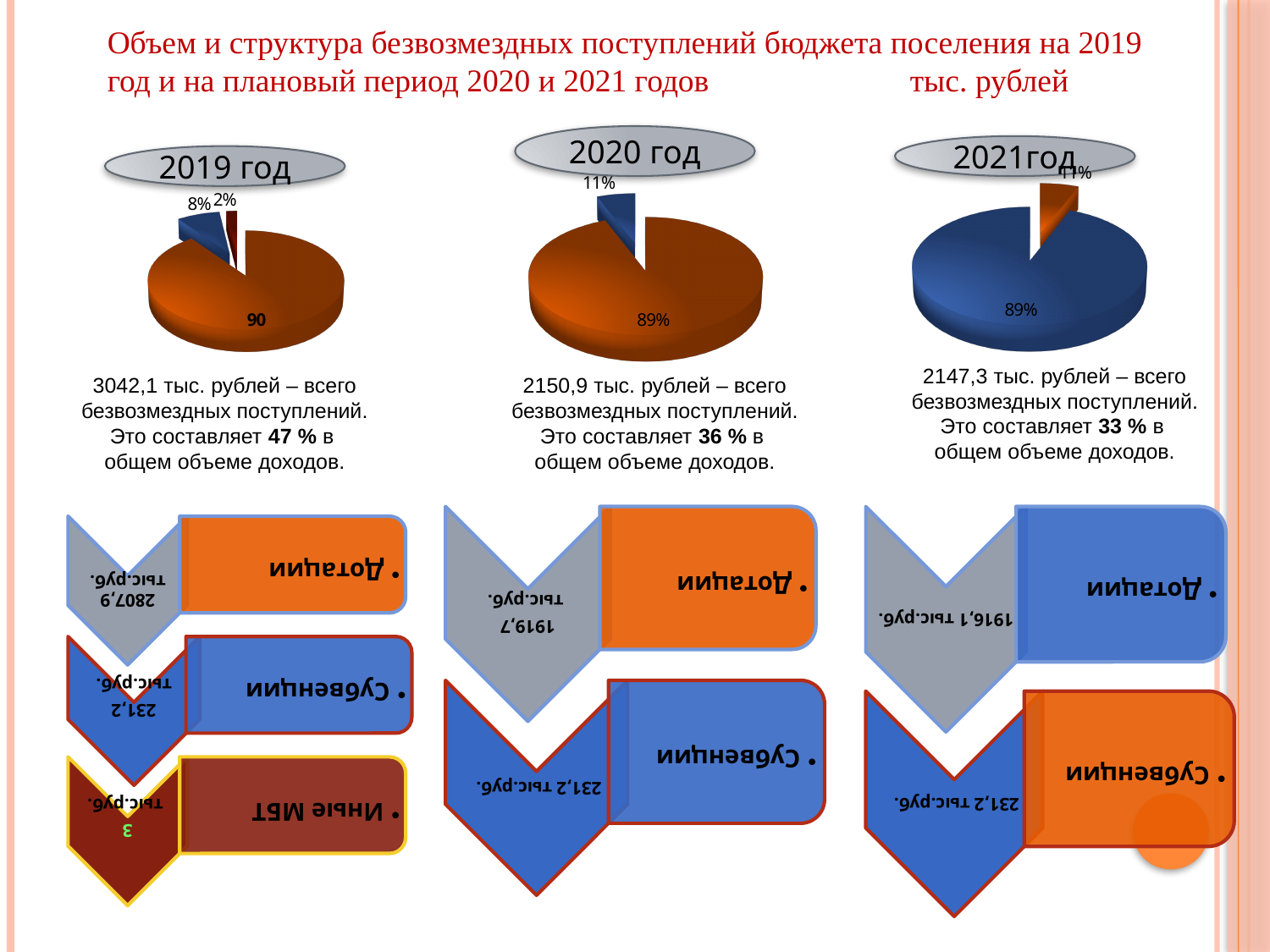
What colour is the largest slice in the "2020 год" pie chart? orange In the "2021год" chart, what percentage is shown on the largest slice? 89% How many slices does the "2020 год" pie chart have? 2 In the "2019 год" chart, what value is printed on the largest slice? 90 In the "2021год" chart, what percentage is shown on the small slice? 11% How many slices does the "2019 год" pie chart have? 3 In the "2020 год" chart, what percentage is shown on the largest slice? 89% In the "2019 год" chart, which of the two small slices is larger, the one labelled 8% or the one labelled 2%? 8% In the "2020 год" chart, what is the difference in percentage points between the 89% slice and the 11% slice? 78 What kind of chart is shown under the heading "2019 год"? pie chart In the "2020 год" chart, what percentage is shown on the smaller slice? 11% What colour is the largest slice in the "2021год" pie chart? blue